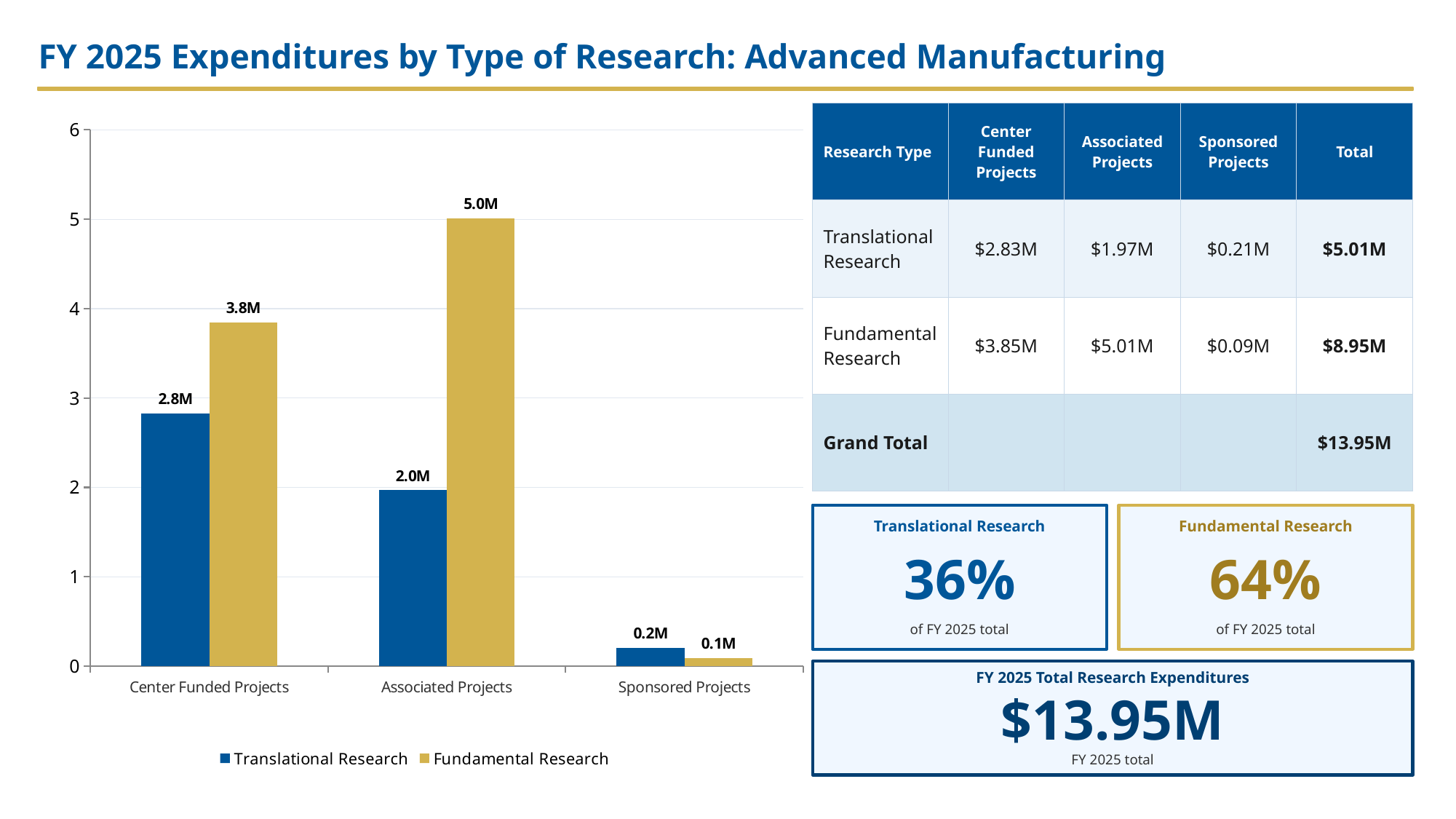
Which colour represents Fundamental Research in the chart? Gold Which category has the lowest Translational Research bar? Sponsored Projects Is the Fundamental Research bar for Center Funded Projects greater or less than 3? greater How many categories are shown on the x axis of the chart? 3 How many series does the chart legend list? 2 What is the value of the Fundamental Research bar for Associated Projects? 5.0M What is the value of the Fundamental Research bar for Sponsored Projects? 0.1M What is the difference between the Fundamental Research and Translational Research bars for Associated Projects, using the data labels? 3.0M For Center Funded Projects, which series has the larger bar: Translational Research or Fundamental Research? Fundamental Research Which category has the highest Fundamental Research bar? Associated Projects What is the value of the Translational Research bar for Center Funded Projects? 2.8M What kind of chart is shown on the slide? Bar chart